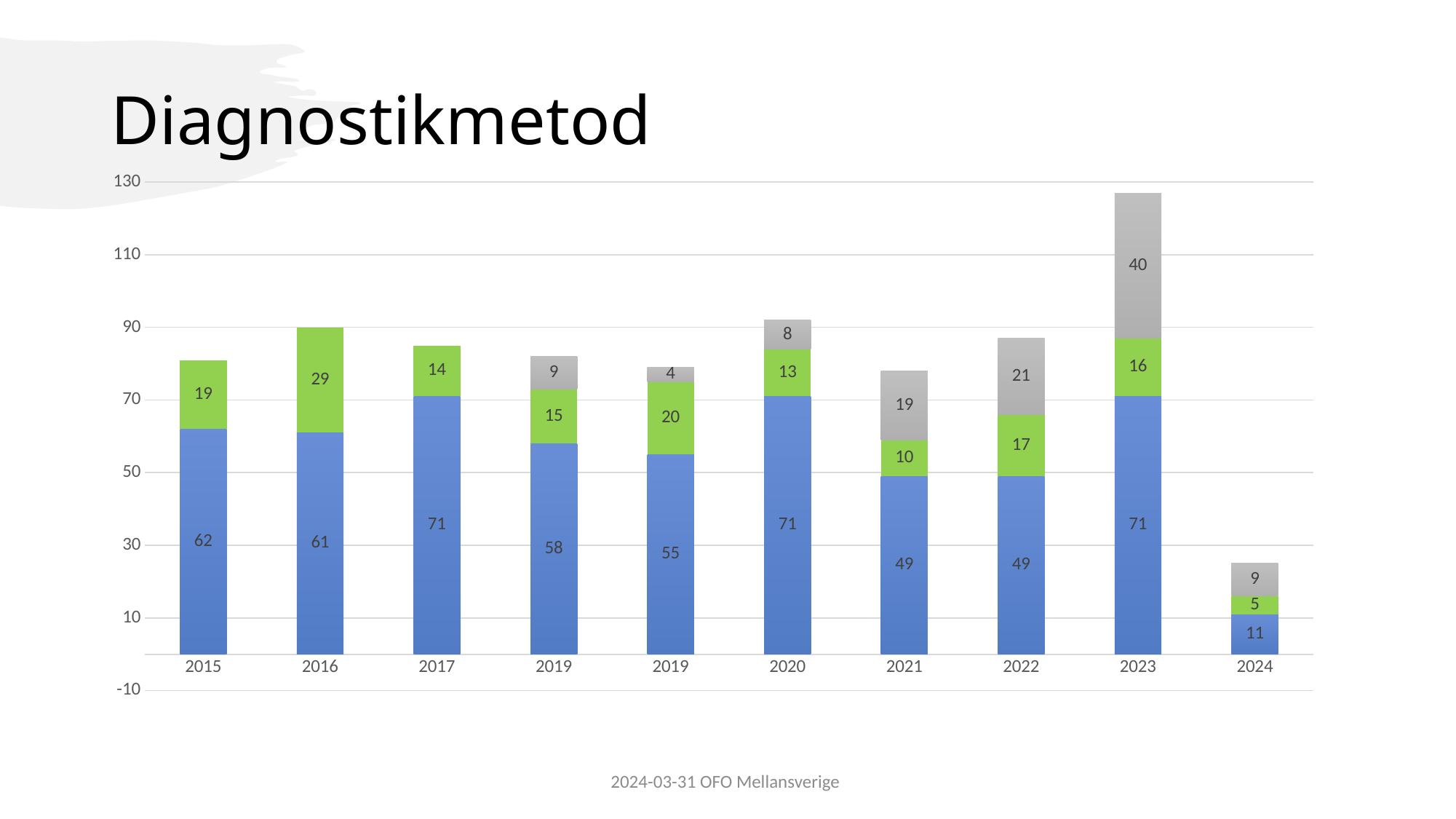
What is the difference between the blue segment for 2017 and the blue segment for 2021? 22 How many stacked bars are shown in the chart? 10 Which year has the shortest stacked bar? 2024 What is the value of the green segment for 2016? 29 What is the value of the blue segment for 2024? 11 What is the total of the stacked bar for 2023? 127 Which is larger, the green segment for 2016 or the green segment for 2022? 2016 What is the value of the grey segment for 2023? 40 What is the value of the blue segment for 2015? 62 What is the total of the stacked bar for 2024? 25 Is the total of the stacked bar for 2023 greater or less than 110? greater Which year has the tallest stacked bar? 2023